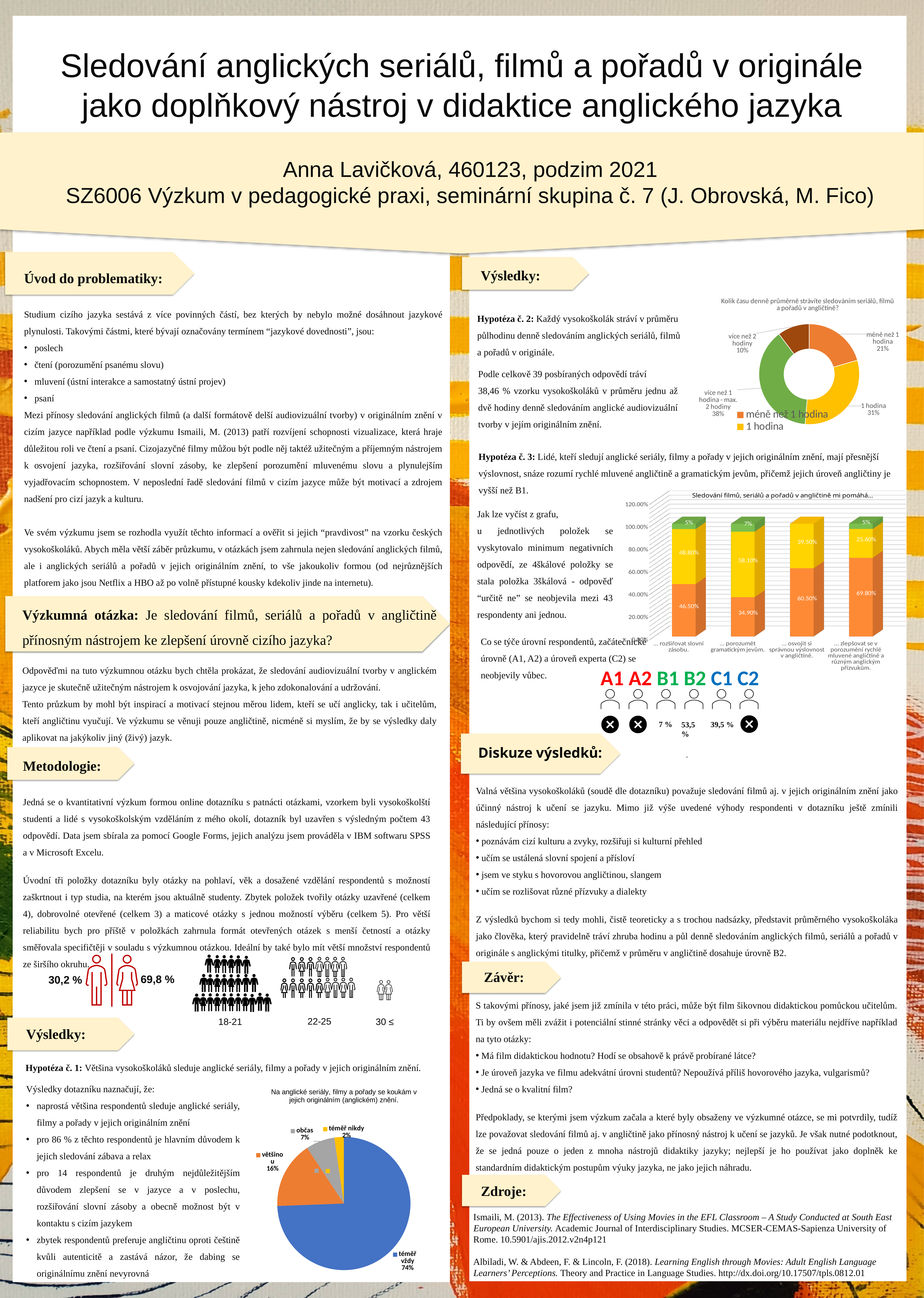
In the pie chart titled 'Na anglické seriály, filmy a pořady se koukám v jejich originálním (anglickém) znění.', which category has the smallest share? téměř nikdy In the chart titled 'Sledování filmů, seriálů a pořadů v angličtině mi pomáhá...', what is the value of the bottom (orange) segment for '... rozšiřovat slovní zásobu.'? 46.50% In the chart titled 'Sledování filmů, seriálů a pořadů v angličtině mi pomáhá...', how many categories are shown on the x axis? 4 In the chart titled 'Sledování filmů, seriálů a pořadů v angličtině mi pomáhá...', which category has the largest bottom (orange) segment? ... zlepšovat se v porozumění rychlé mluvené angličtině a různým anglickým přízvukům. In the pie chart titled 'Na anglické seriály, filmy a pořady se koukám v jejich originálním (anglickém) znění.', how many slices are there? 4 In the pie chart titled 'Na anglické seriály, filmy a pořady se koukám v jejich originálním (anglickém) znění.', what percentage is shown for 'téměř vždy'? 74% In the chart titled 'Sledování filmů, seriálů a pořadů v angličtině mi pomáhá...', what is the value of the bottom (orange) segment for '... osvojit si správnou výslovnost v angličtině.'? 60.50% In the donut chart titled 'Kolik času denně průměrně strávíte sledováním seriálů, filmů a pořadů v angličtině?', which category has the largest share? více než 1 hodina - max. 2 hodiny In the donut chart titled 'Kolik času denně průměrně strávíte sledováním seriálů, filmů a pořadů v angličtině?', which is larger: 'méně než 1 hodina' or 'více než 2 hodiny'? méně než 1 hodina What kind of chart is the one titled 'Sledování filmů, seriálů a pořadů v angličtině mi pomáhá...'? stacked bar chart In the pie chart titled 'Na anglické seriály, filmy a pořady se koukám v jejich originálním (anglickém) znění.', what is the difference between 'většinou' and 'občas'? 9% In the donut chart titled 'Kolik času denně průměrně strávíte sledováním seriálů, filmů a pořadů v angličtině?', what percentage is shown for '1 hodina'? 31%